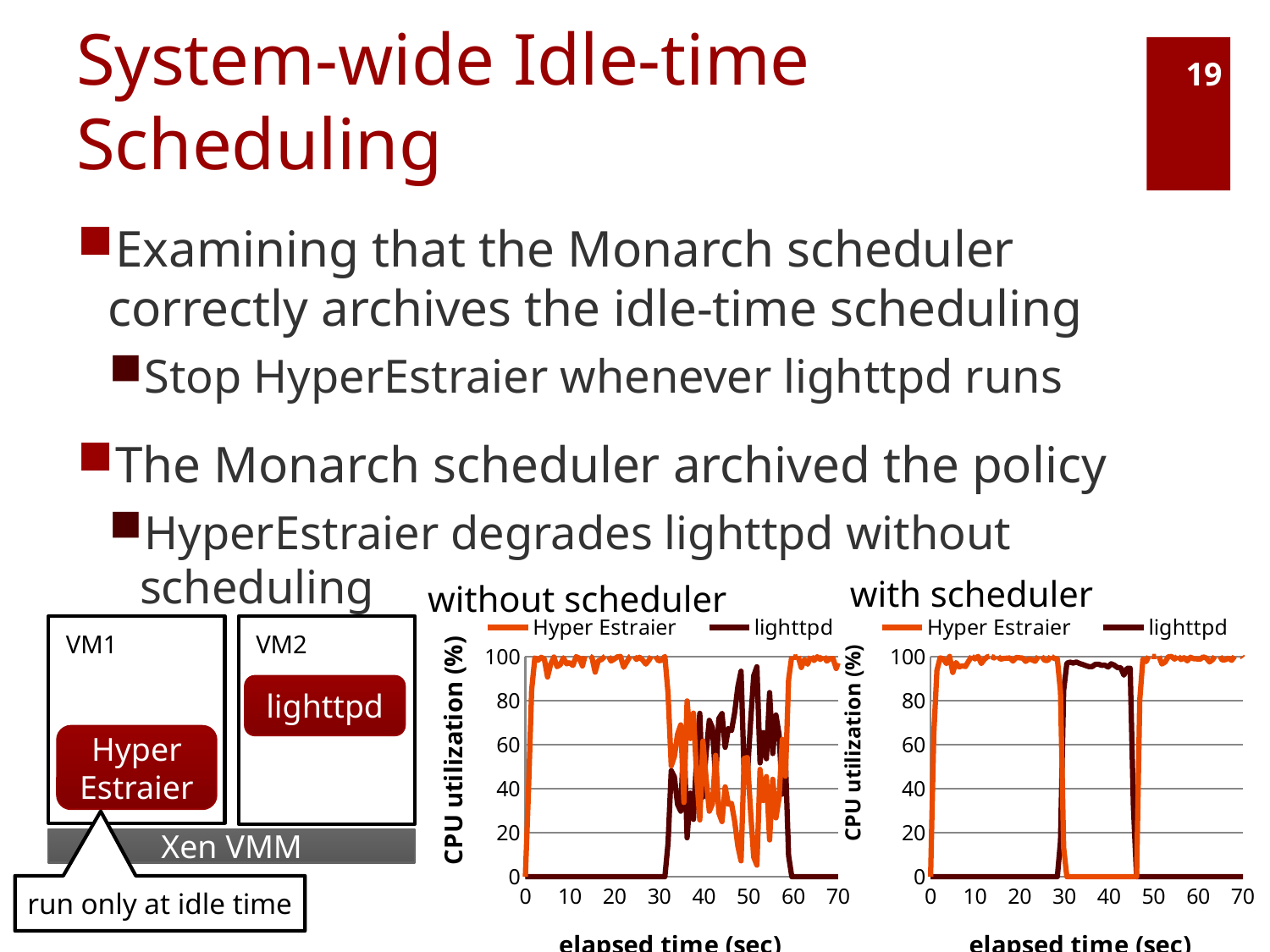
What is the y-axis label of the "with scheduler" chart? CPU utilization (%) In the "with scheduler" chart, which series has the larger value at 40 seconds, Hyper Estraier or lighttpd? lighttpd How many series does the legend of the "with scheduler" chart list? 2 In the "without scheduler" chart, is the value for Hyper Estraier at 10 seconds greater or less than 80? greater In the "with scheduler" chart, is the value for lighttpd at 40 seconds greater or less than 80? greater In the "without scheduler" chart, is the value for lighttpd at 10 seconds greater or less than 20? less In the "without scheduler" chart, which two series are listed in the legend? Hyper Estraier and lighttpd What kind of chart is the "without scheduler" chart? line chart In the "without scheduler" chart, which series has the larger value at 10 seconds, Hyper Estraier or lighttpd? Hyper Estraier What kind of chart is the "with scheduler" chart? line chart